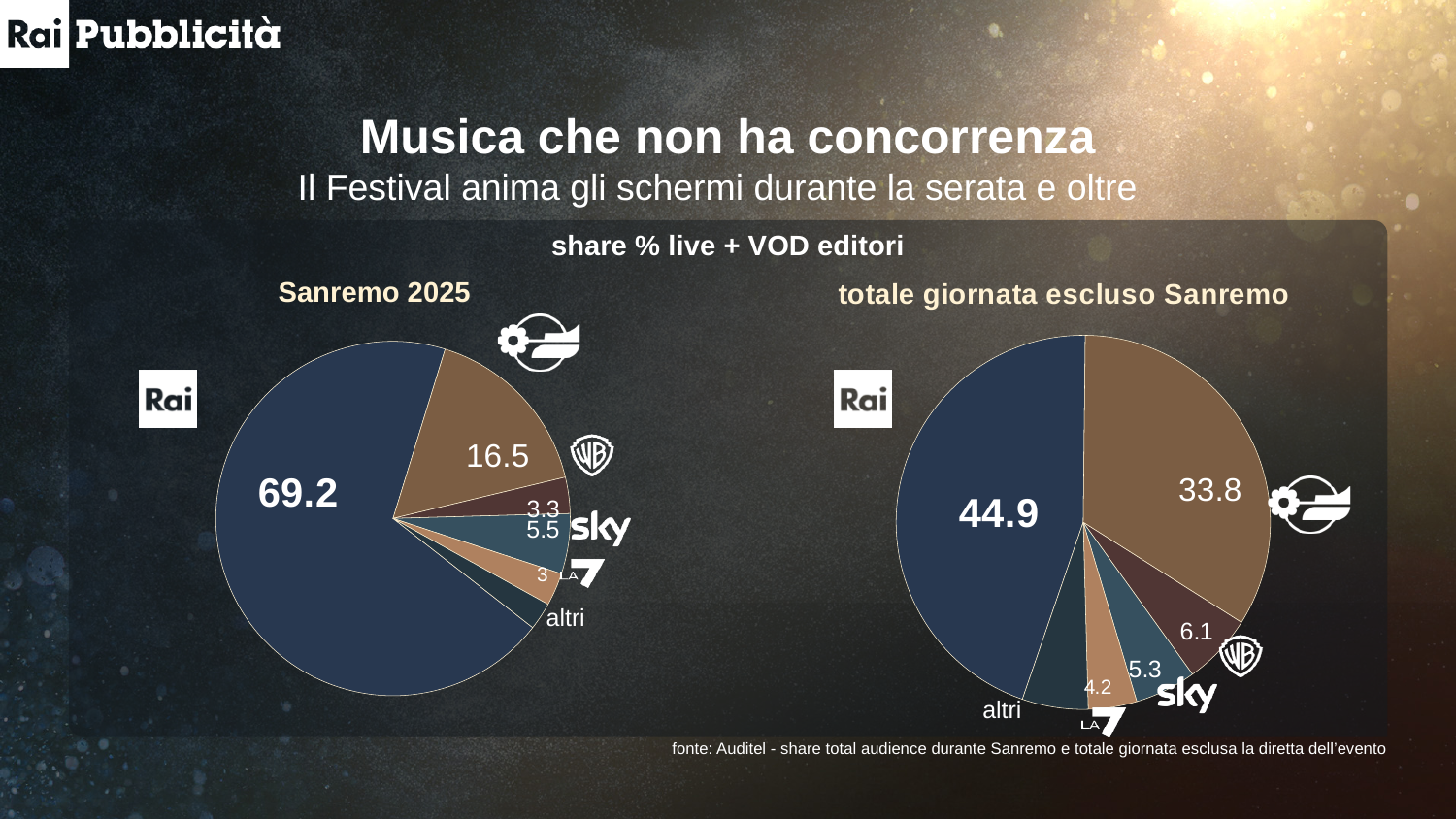
In the 'totale giornata escluso Sanremo' pie chart, which editor has the largest slice? Rai In the 'totale giornata escluso Sanremo' pie chart, what share does Rai have? 44.9 In the 'totale giornata escluso Sanremo' pie chart, what is the value of the Sky slice? 5.3 What kind of chart is used on this slide for the Sanremo 2025 data? Pie chart How many slices does the Sanremo 2025 pie chart have? 6 In the Sanremo 2025 pie chart, which is larger, the Sky slice or the La7 slice? Sky In the Sanremo 2025 pie chart, what is the value of the Sky slice? 5.5 In the 'totale giornata escluso Sanremo' pie chart, what is the value of the La7 slice? 4.2 In the Sanremo 2025 pie chart, which editor has the largest slice? Rai In the Sanremo 2025 pie chart, what share does Rai have? 69.2 In the Sanremo 2025 pie chart, what is the value of the La7 slice? 3 How much higher is Rai's share in the Sanremo 2025 chart than in the 'totale giornata escluso Sanremo' chart? 24.3